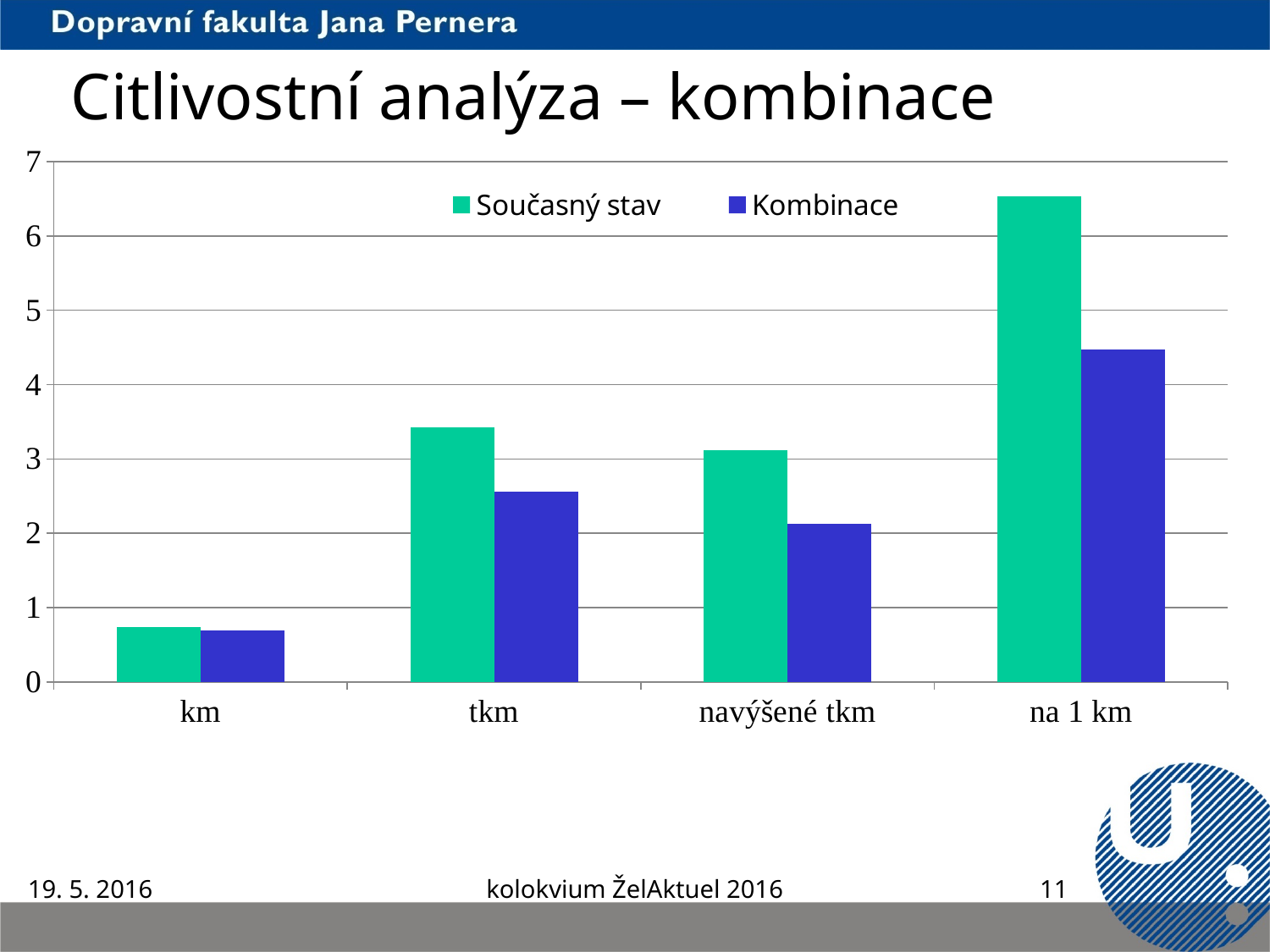
Is the Současný stav value for km greater or less than 1? less Is the Současný stav value for na 1 km greater or less than 6? greater How many series does the legend list? 2 What is the title of the slide containing the chart? Citlivostní analýza – kombinace Is the Kombinace value for tkm greater or less than 3? less What kind of chart is shown on the slide? bar chart How many categories are shown on the x axis? 4 For the category tkm, which series has the larger value, Současný stav or Kombinace? Současný stav Which category has the highest value for Kombinace? na 1 km Which category has the lowest value for Kombinace? km What are the two series named in the legend? Současný stav and Kombinace Which category has the highest value for Současný stav? na 1 km